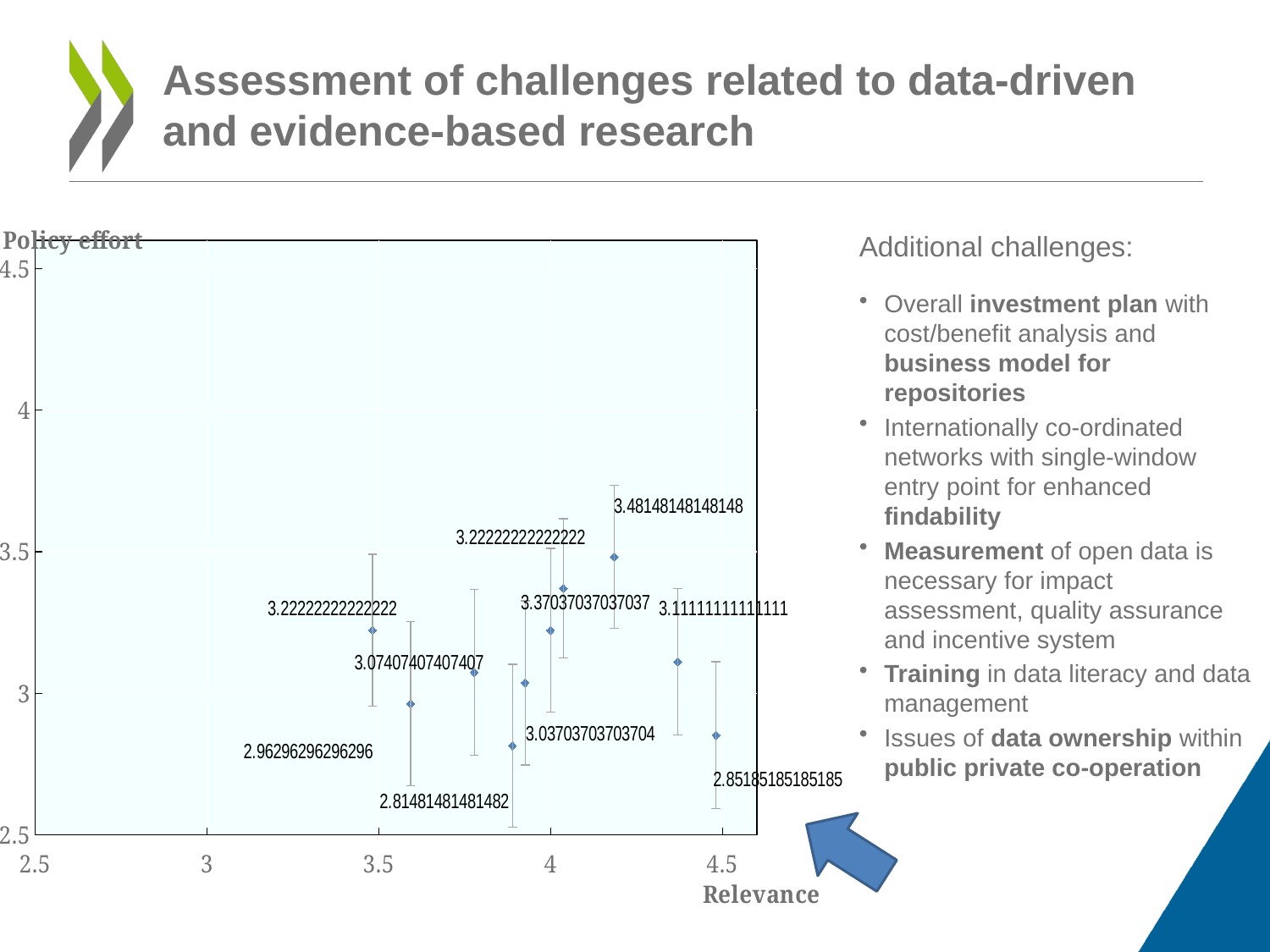
What is the data label of the rightmost point in the chart? 2.85185185185185 How many data points are plotted in the chart? 10 What kind of chart is shown on the slide? scatter chart What is the data label of the leftmost point in the chart? 3.22222222222222 What is the label of the vertical axis of the chart? Policy effort Is the relevance value of the highest point (labelled 3.48148148148148) greater or less than 4? greater What is the label of the horizontal axis of the chart? Relevance Which is larger, the point labelled 3.37037037037037 or the point labelled 3.03703703703704? 3.37037037037037 Is the policy effort of the rightmost point (labelled 2.85185185185185) greater or less than 3? less What is the highest policy effort value labelled on the chart? 3.48148148148148 What is the lowest policy effort value labelled on the chart? 2.81481481481482 What is the difference between the highest labelled value (3.48148148148148) and the lowest labelled value (2.81481481481482)? 0.66666666666666